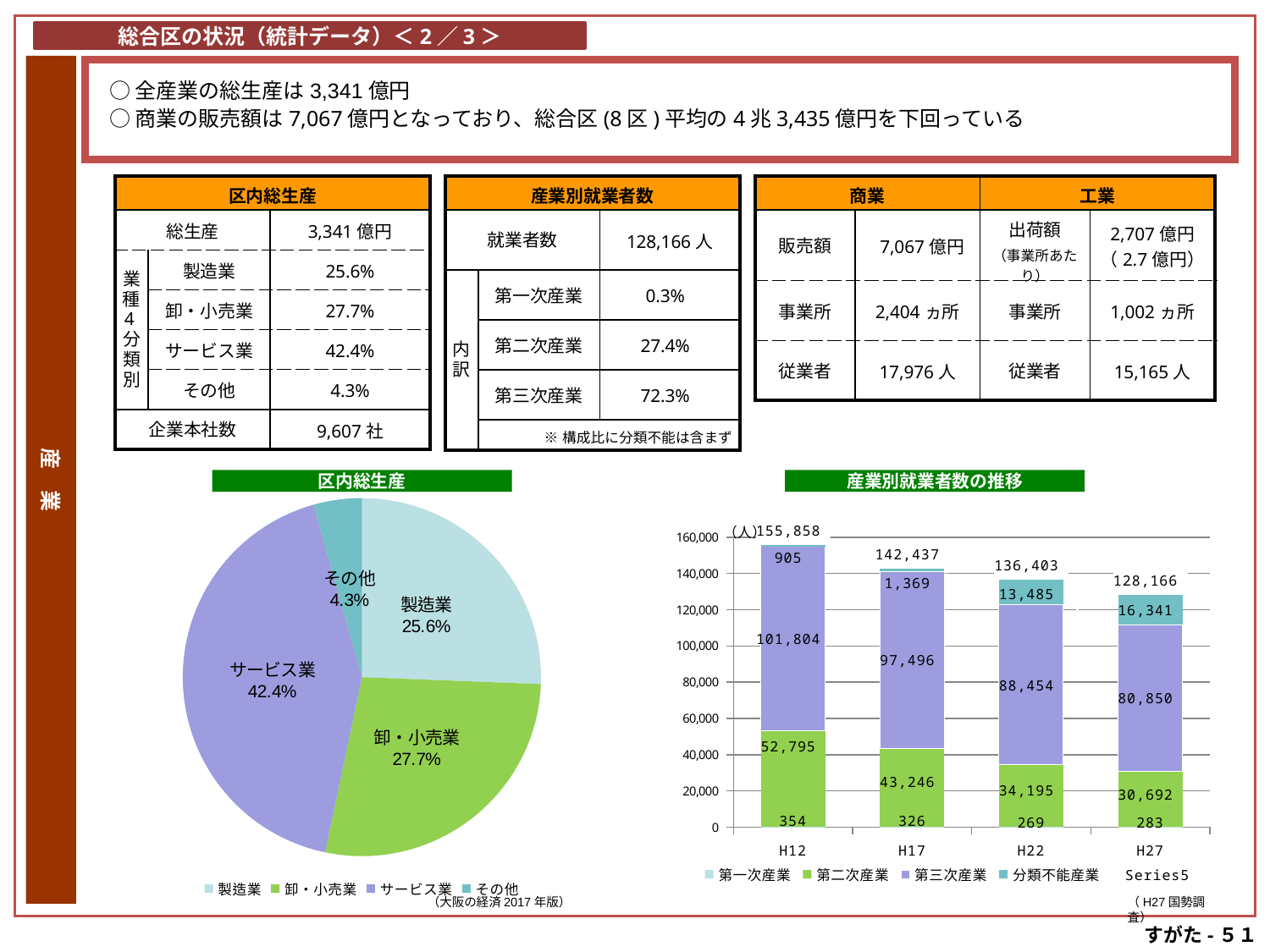
What kind of chart is the 区内総生産 chart? pie chart In the 区内総生産 pie chart, what share does サービス業 have? 42.4% In the 産業別就業者数の推移 chart, what is the difference between the 第二次産業 values for H12 and H27? 22,103 In the 区内総生産 pie chart, which category has the largest share? サービス業 In the 区内総生産 pie chart, which category has the smallest share? その他 In the 区内総生産 pie chart, how many slices are there? 4 In the 産業別就業者数の推移 chart, which is larger: 分類不能産業 in H22 or in H27? H27 What kind of chart is the 産業別就業者数の推移 chart? stacked bar chart In the 産業別就業者数の推移 chart, what is the value for 第三次産業 in H22? 88,454 In the 産業別就業者数の推移 chart, do the bar totals rise or fall from H12 to H27? fall In the 産業別就業者数の推移 chart, how many entries does the legend list? 5 In the 産業別就業者数の推移 chart, what is the total of the stacked bar for H17? 142,437